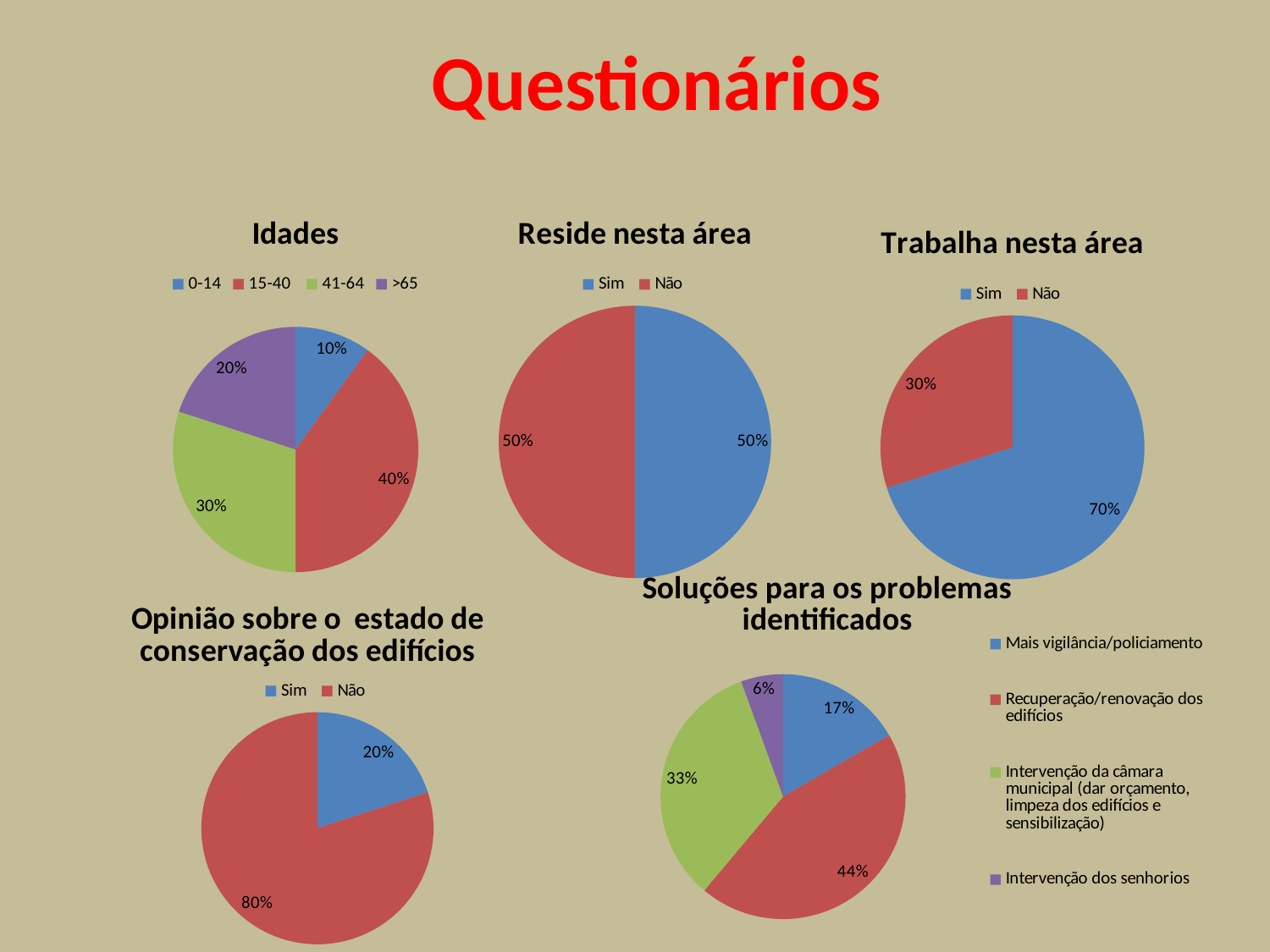
In the 'Idades' chart, what share does the 15-40 age group have? 40% In the 'Opinião sobre o estado de conservação dos edifícios' chart, which is larger, 'Sim' or 'Não'? Não In the 'Soluções para os problemas identificados' chart, which solution has the largest share? Recuperação/renovação dos edifícios In the 'Soluções para os problemas identificados' chart, what share is 'Intervenção dos senhorios'? 6% In the 'Trabalha nesta área' chart, what share is 'Não'? 30% In the 'Idades' chart, how many categories does the legend list? 4 What type of chart is used for 'Soluções para os problemas identificados'? Pie chart In the 'Reside nesta área' chart, what share is 'Sim'? 50% In the 'Trabalha nesta área' chart, what is the difference between the 'Sim' and 'Não' shares? 40% In the 'Opinião sobre o estado de conservação dos edifícios' chart, what share is 'Não'? 80% In the 'Idades' chart, which age group has the largest share? 15-40 In the 'Idades' chart, which age group has the smallest share? 0-14